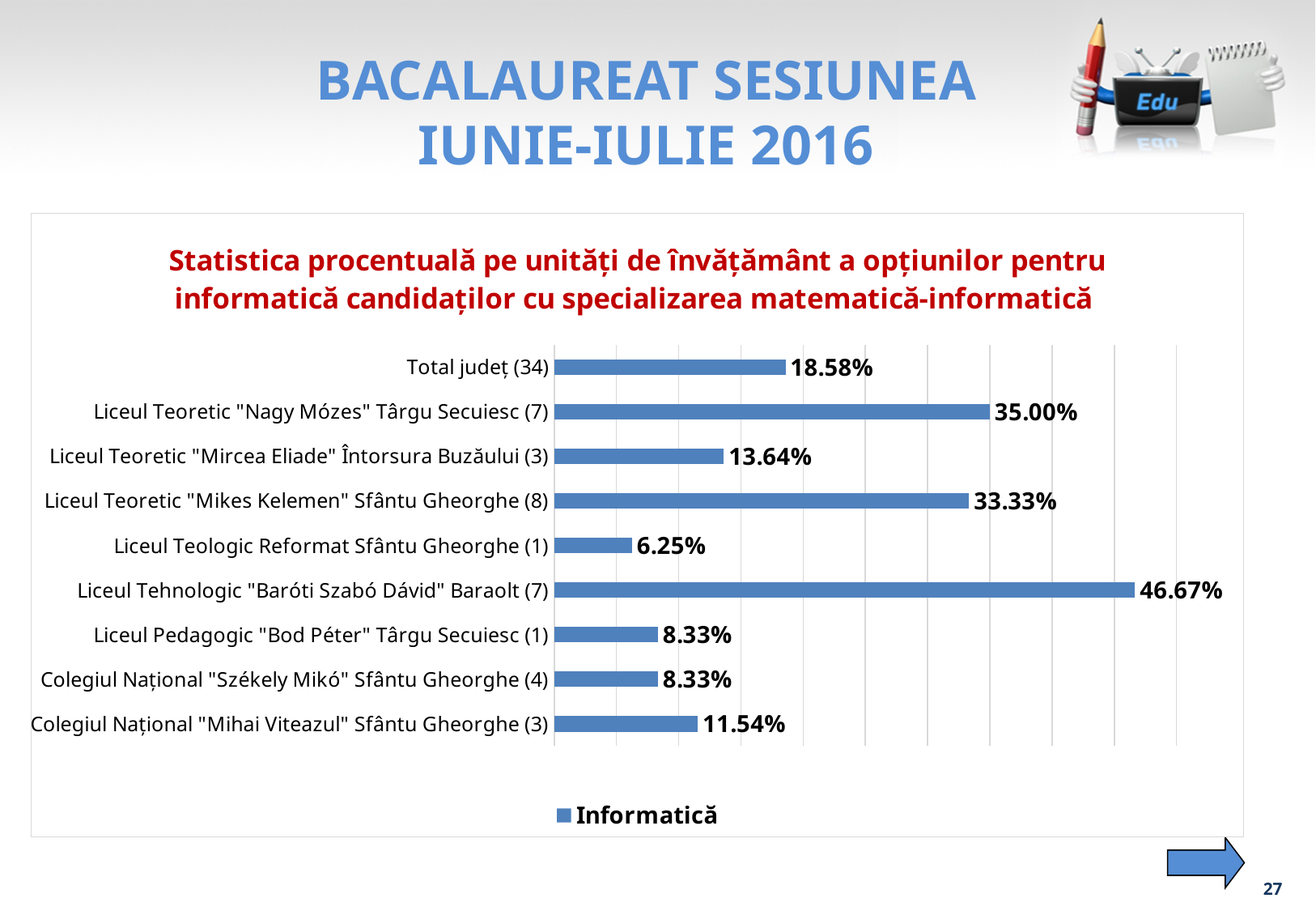
Which category has the highest value? Liceul Tehnologic "Baróti Szabó Dávid" Baraolt (7) What is the name of the series shown in the legend? Informatică What is the difference between the values for Liceul Teoretic "Nagy Mózes" Târgu Secuiesc (7) and Liceul Teoretic "Mikes Kelemen" Sfântu Gheorghe (8)? 1.67% What kind of chart is shown on the slide? Bar chart How many categories are shown on the chart? 9 How many series does the legend list? 1 What is the value for Liceul Teologic Reformat Sfântu Gheorghe (1)? 6.25% What is the value for Total județ (34)? 18.58% What is the difference between the value for Liceul Tehnologic "Baróti Szabó Dávid" Baraolt (7) and Total județ (34)? 28.09% Which category has the lowest value? Liceul Teologic Reformat Sfântu Gheorghe (1) Which is larger: the value for Liceul Teoretic "Mircea Eliade" Întorsura Buzăului (3) or Colegiul Național "Mihai Viteazul" Sfântu Gheorghe (3)? Liceul Teoretic "Mircea Eliade" Întorsura Buzăului (3) What is the value for Liceul Tehnologic "Baróti Szabó Dávid" Baraolt (7)? 46.67%